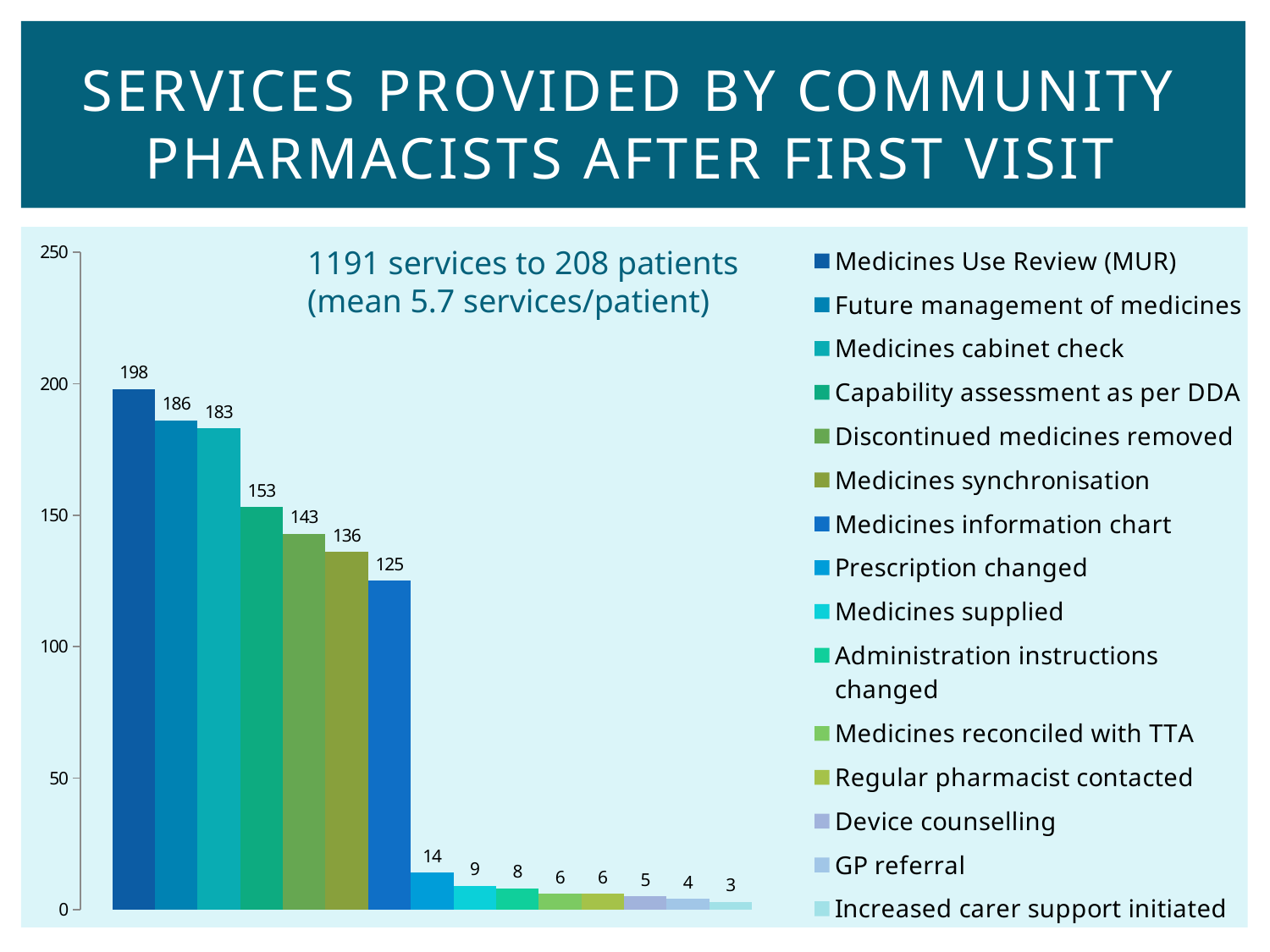
Which service has the highest value? Medicines Use Review (MUR) What is the difference between the values for Future management of medicines and Medicines cabinet check? 3 What is the value for Medicines Use Review (MUR)? 198 How many entries does the legend list? 15 What kind of chart is shown on the slide? bar chart What is the value for Capability assessment as per DDA? 153 Is the value for Discontinued medicines removed greater or less than 150? less What is the value for Prescription changed? 14 Which is larger, the value for Medicines synchronisation or the value for Medicines information chart? Medicines synchronisation How many bars are plotted in the chart? 15 What is the value for GP referral? 4 Which service has the lowest value? Increased carer support initiated